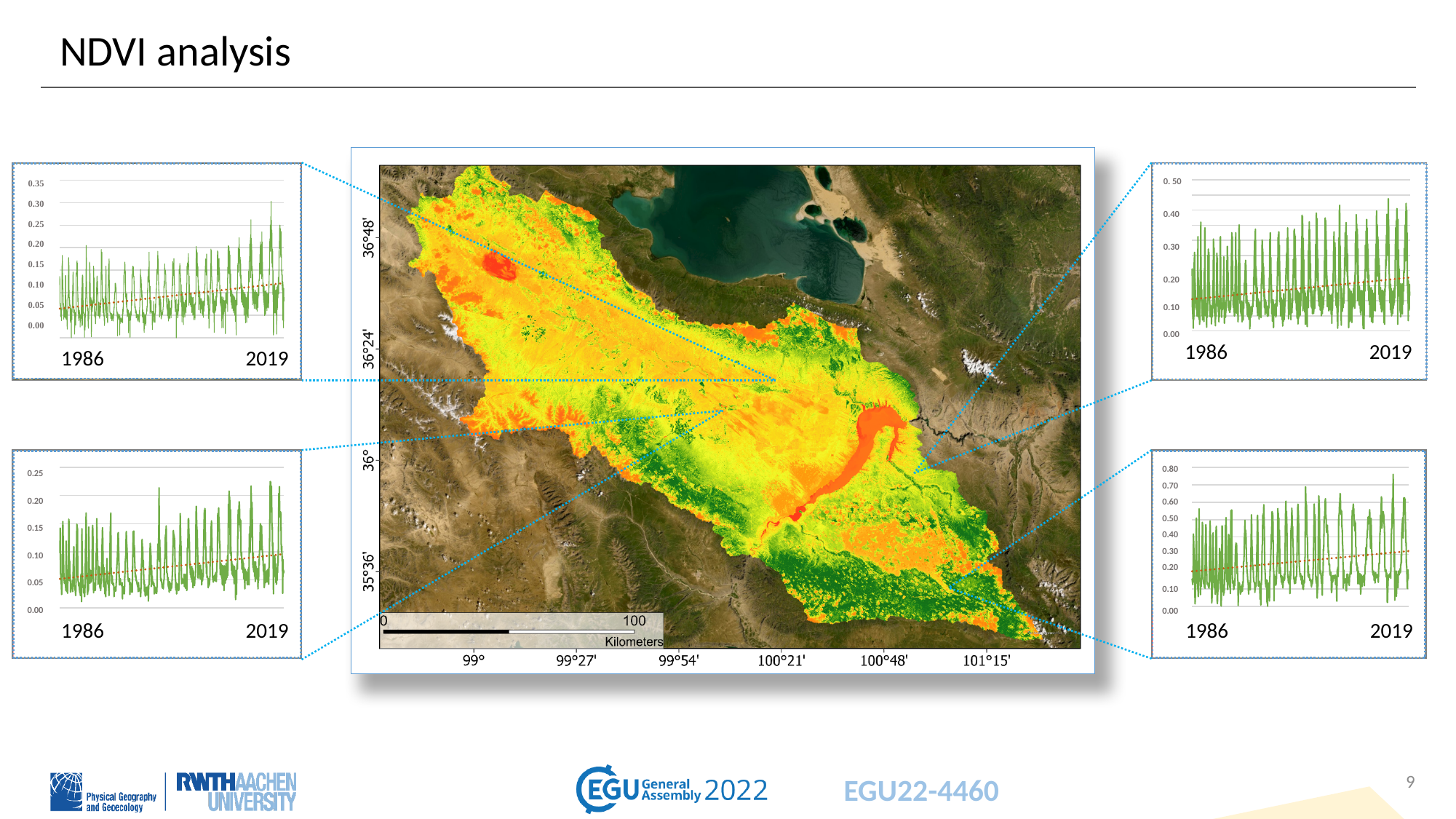
In the bottom-right chart, does the dotted trend line rise or fall from 1986 to 2019? rise What is the first year shown on the x axis of the bottom-left chart? 1986 What is the last year shown on the x axis of the top-right chart? 2019 In the top-left chart, is the highest peak of the green line greater or less than 0.25? greater In the bottom-left chart, is the highest peak of the green line greater or less than 0.20? greater What kind of chart is the top-left chart on the slide? line chart What colour is the dotted trend line in each of the four time-series charts? red In the top-left chart, does the dotted trend line rise or fall from 1986 to 2019? rise How many time-series charts surround the map on the slide? 4 What is the highest tick value on the y axis of the top-right chart? 0.50 In the bottom-right chart, is the highest peak of the green line greater or less than 0.70? greater What is the highest tick value on the y axis of the bottom-right chart? 0.80